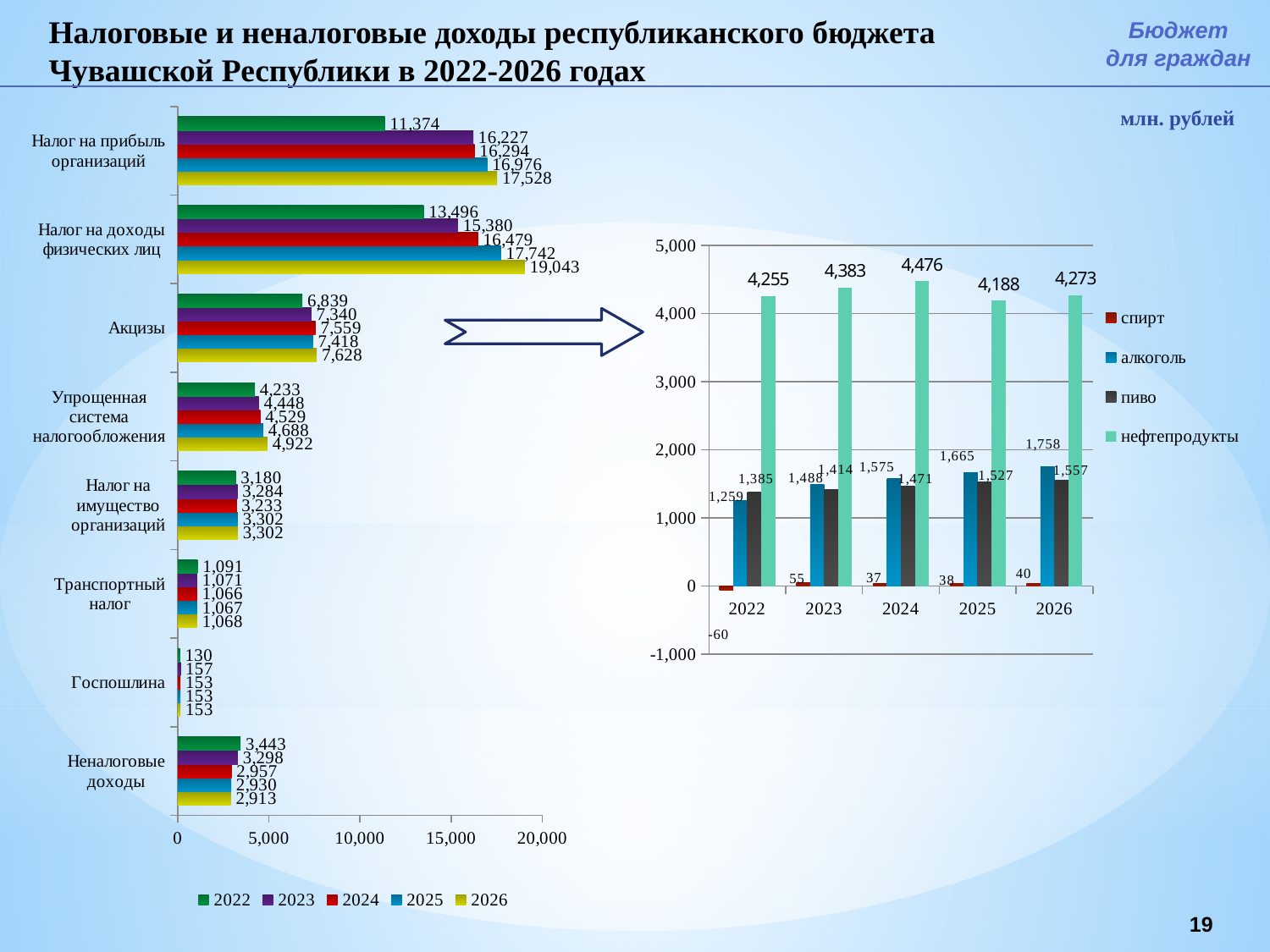
On the left chart, what is the value for Налог на доходы физических лиц in 2022? 13,496 On the left chart, which category has the highest value in 2026? Налог на доходы физических лиц On the right chart, do the values for алкоголь rise or fall from 2022 to 2026? rise On the left chart, what is the difference between the 2026 and 2022 values for Акцизы? 789 What kind of chart is the right chart? bar chart How many categories are shown on the left chart? 8 How many series does the legend of the left chart list? 5 On the right chart, in which year is the value for нефтепродукты highest? 2024 On the left chart, which category has the lowest value in 2022? Госпошлина On the left chart, what is the value for Налог на прибыль организаций in 2026? 17,528 On the right chart, which is larger in 2026: алкоголь or пиво? алкоголь On the right chart, what is the value for нефтепродукты in 2024? 4,476